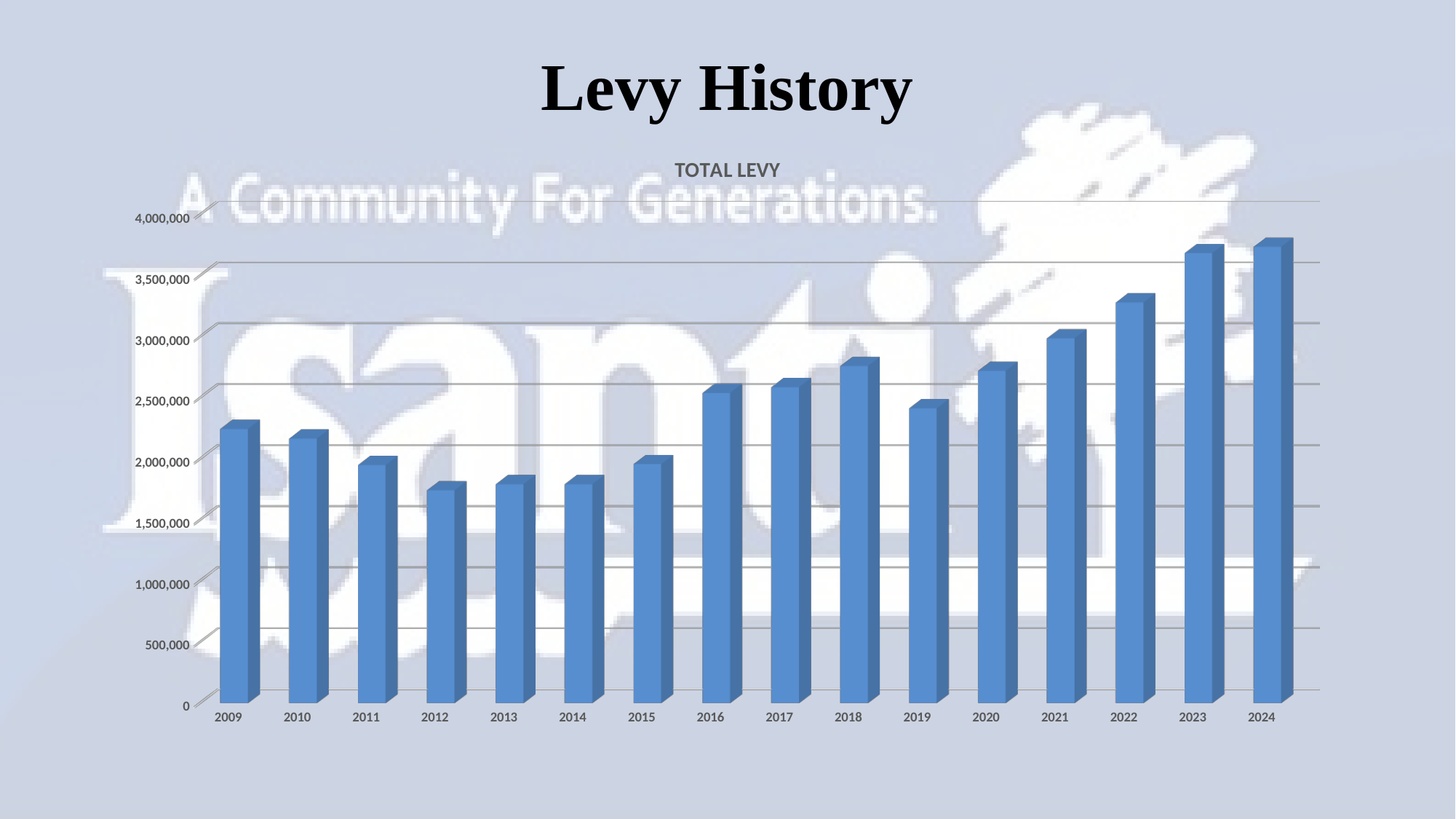
Is the value for 2021 greater or less than 2,500,000? greater How many years are plotted on the x axis? 16 Is the value for 2023 greater or less than 3,500,000? greater Overall, do the total levy values rise or fall from 2009 to 2024? Rise Is the value for 2012 greater or less than 2,000,000? less Which is larger, the total levy for 2012 or for 2018? 2018 What kind of chart is shown on the slide? Bar chart Which is larger, the total levy for 2009 or for 2024? 2024 Which year has the highest total levy? 2024 What is the title of the chart? TOTAL LEVY